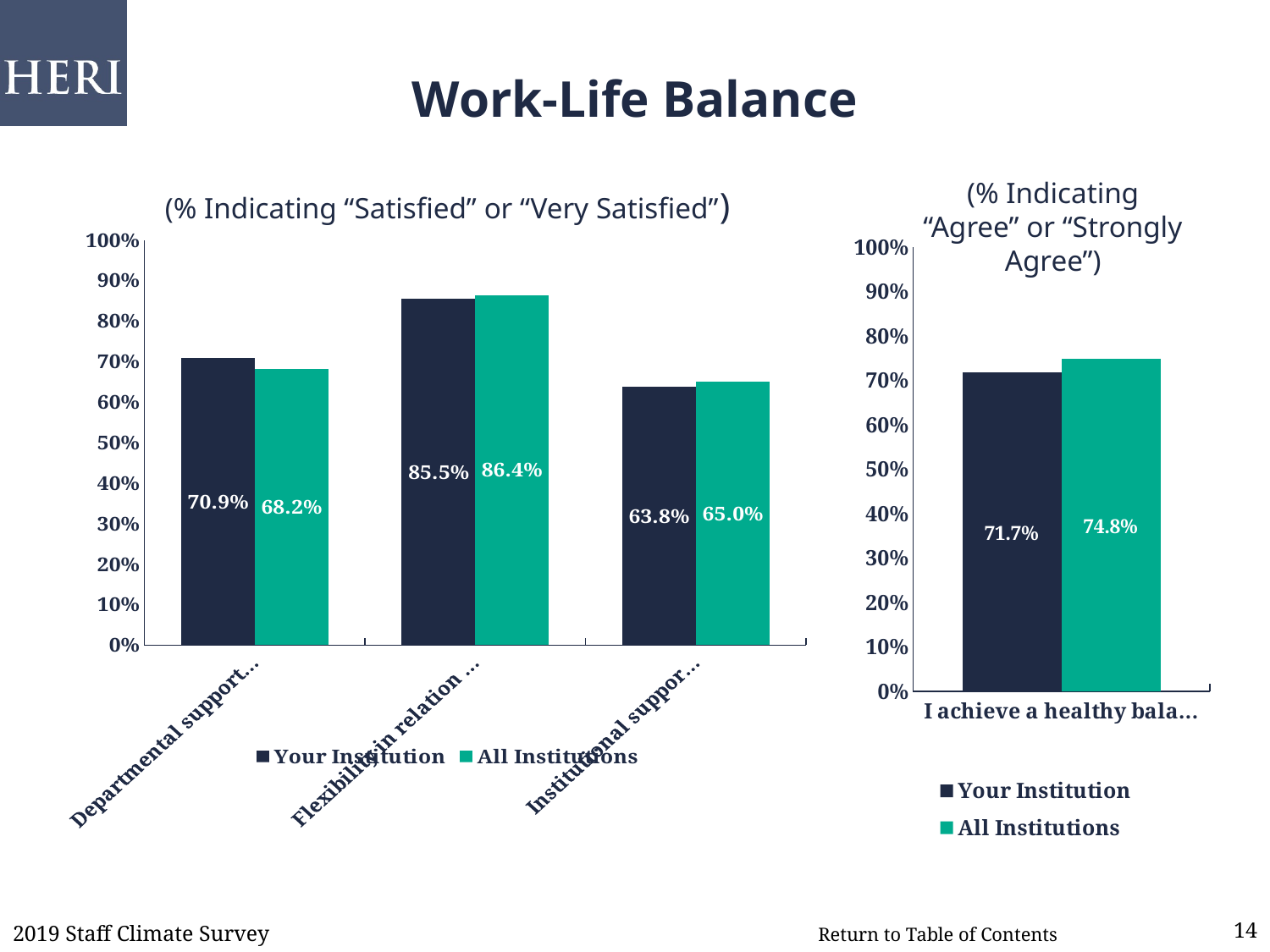
In the left chart (% Indicating "Satisfied" or "Very Satisfied"), what is the value for All Institutions on the second category (Flexibility in relation...)? 86.4% In the left chart (% Indicating "Satisfied" or "Very Satisfied"), which category has the highest value for Your Institution? Flexibility in relation... (the second category) In the left chart (% Indicating "Satisfied" or "Very Satisfied"), which category has the lowest value for All Institutions? Institutional support (the third category) In the left chart (% Indicating "Satisfied" or "Very Satisfied"), which is larger on the third category (Institutional support): Your Institution or All Institutions? All Institutions In the left chart (% Indicating "Satisfied" or "Very Satisfied"), what is the value for Your Institution on the first category (Departmental support)? 70.9% In the right chart (% Indicating "Agree" or "Strongly Agree"), what is the difference between All Institutions and Your Institution? 3.1 percentage points In the left chart (% Indicating "Satisfied" or "Very Satisfied"), what is the difference between Your Institution and All Institutions on the first category (Departmental support)? 2.7 percentage points In the right chart (% Indicating "Agree" or "Strongly Agree"), what is the value for All Institutions? 74.8% How many series does the legend of the left chart (% Indicating "Satisfied" or "Very Satisfied") list? 2 How many categories are shown on the x axis of the left chart (% Indicating "Satisfied" or "Very Satisfied")? 3 What kind of chart is the right chart (% Indicating "Agree" or "Strongly Agree")? Bar chart In the left chart (% Indicating "Satisfied" or "Very Satisfied"), what is the value for Your Institution on the third category (Institutional support)? 63.8%